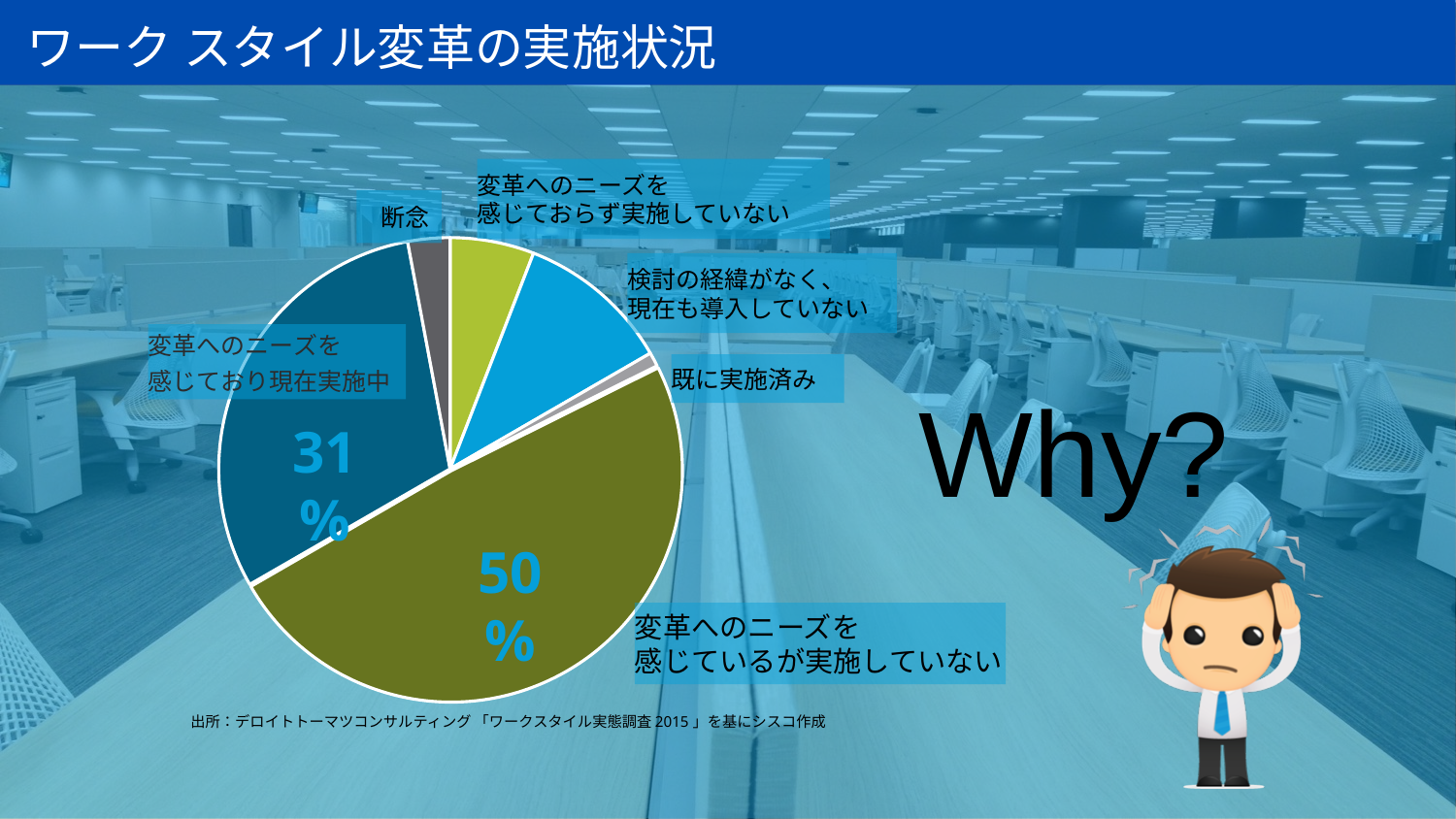
Which slice is larger: 断念 or 変革へのニーズを感じておらず実施していない? 変革へのニーズを感じておらず実施していない What kind of chart is shown on the slide? Pie chart What is the difference in percentage points between the 変革へのニーズを感じているが実施していない slice and the 変革へのニーズを感じており現在実施中 slice? 19 percentage points Which survey is cited as the source of the pie chart data? デロイトトーマツコンサルティング「ワークスタイル実態調査 2015」 What is the title of the slide containing the pie chart? ワーク スタイル変革の実施状況 How many categories (slices) does the pie chart have? 6 Which category has the largest slice of the pie? 変革へのニーズを感じているが実施していない What share of the pie is labelled for 変革へのニーズを感じているが実施していない? 50% Which slice is larger: 変革へのニーズを感じており現在実施中 or 検討の経緯がなく、現在も導入していない? 変革へのニーズを感じており現在実施中 What share of the pie is labelled for 変革へのニーズを感じており現在実施中? 31%